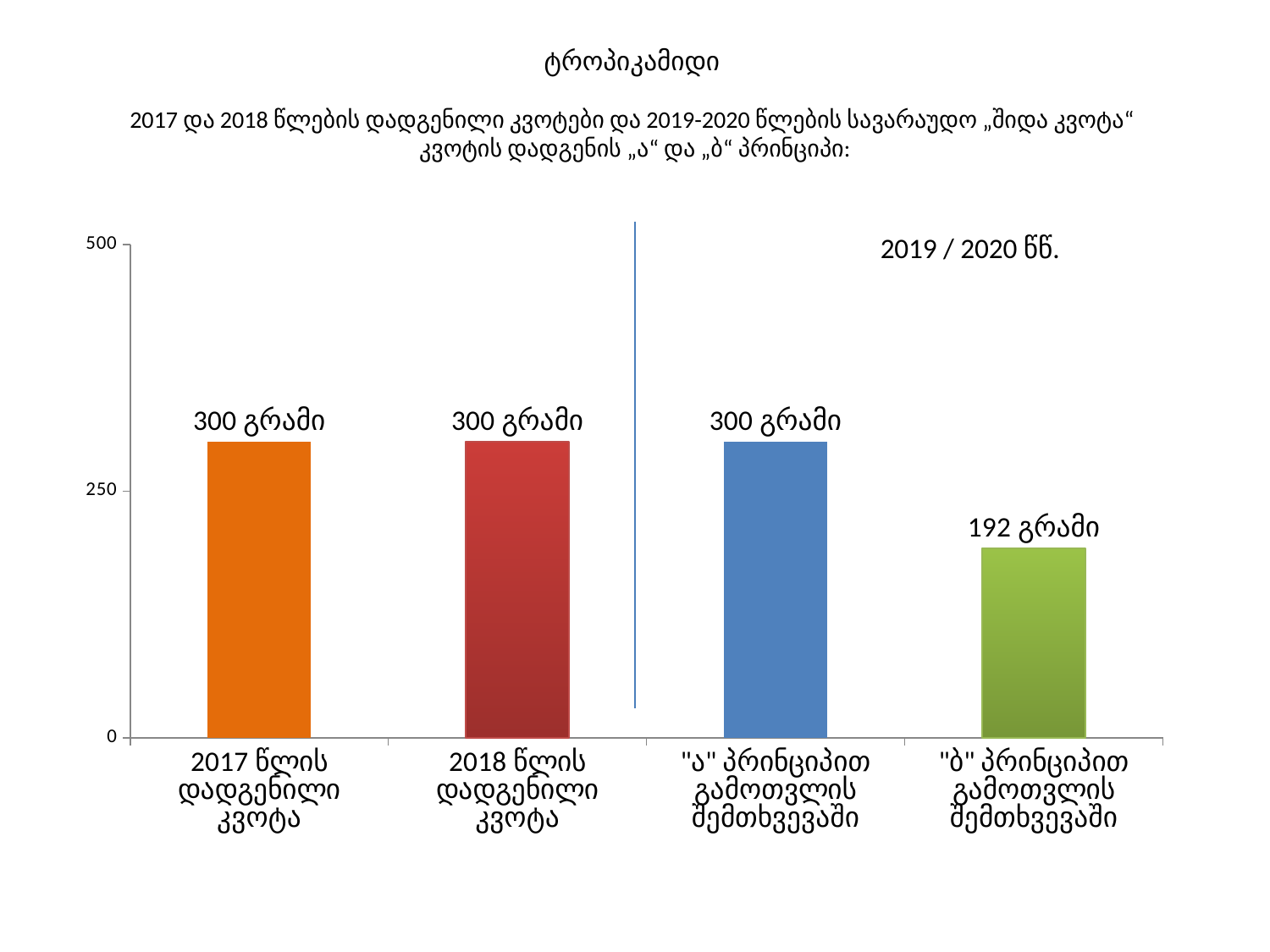
What is the difference between the "ა" პრინციპით and "ბ" პრინციპით values? 108 გრამი What kind of chart is shown on the slide? bar chart What is the title of the slide? ტროპიკამიდი Which is larger: the value for "ა" პრინციპით გამოთვლის შემთხვევაში or for "ბ" პრინციპით გამოთვლის შემთხვევაში? "ა" პრინციპით გამოთვლის შემთხვევაში What is the value for the "ბ" პრინციპით გამოთვლის შემთხვევაში bar? 192 გრამი What is the value for the "ა" პრინციპით გამოთვლის შემთხვევაში bar? 300 გრამი Which category has the lowest value? "ბ" პრინციპით გამოთვლის შემთხვევაში What is the value for the 2018 წლის დადგენილი კვოტა bar? 300 გრამი How many bars are shown in the chart? 4 Is the value for 2017 წლის დადგენილი კვოტა greater or less than 250? greater What is the value for the 2017 წლის დადგენილი კვოტა bar? 300 გრამი Is the value for "ბ" პრინციპით გამოთვლის შემთხვევაში greater or less than 250? less